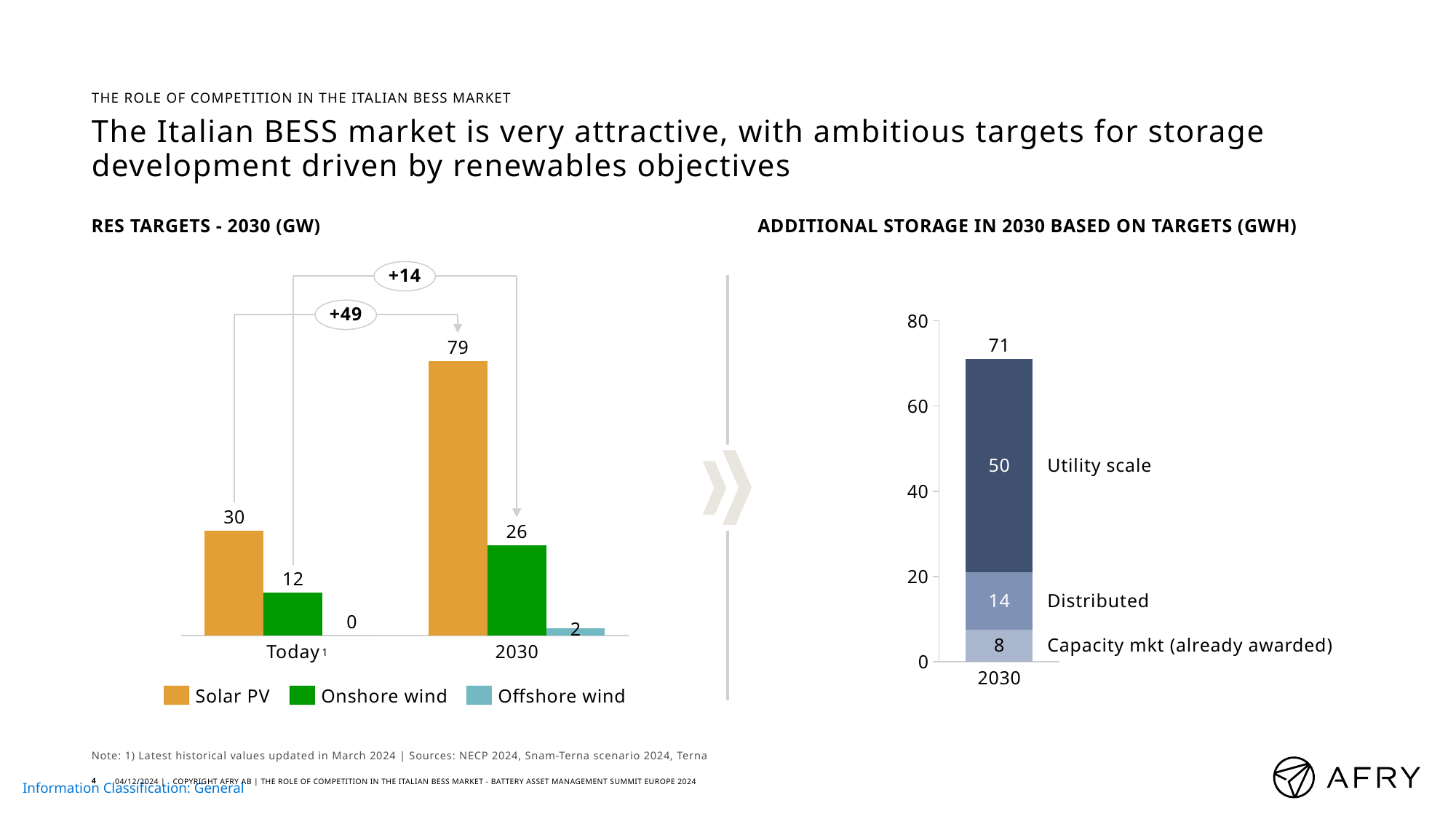
In the 'RES TARGETS - 2030 (GW)' chart, what is the value for Solar PV in 2030? 79 In the 'RES TARGETS - 2030 (GW)' chart, how many series does the legend list? 3 In the 'RES TARGETS - 2030 (GW)' chart, does Solar PV rise or fall from Today to 2030? rise In the 'RES TARGETS - 2030 (GW)' chart, what is the difference between Solar PV in 2030 and Solar PV Today? 49 In the 'ADDITIONAL STORAGE IN 2030 BASED ON TARGETS (GWH)' chart, which segment is larger, Distributed or Capacity mkt (already awarded)? Distributed In the 'RES TARGETS - 2030 (GW)' chart, what is the value for Onshore wind for Today? 12 In the 'RES TARGETS - 2030 (GW)' chart, which series has the highest value in 2030? Solar PV In the 'ADDITIONAL STORAGE IN 2030 BASED ON TARGETS (GWH)' chart, what is the value for Utility scale? 50 In the 'ADDITIONAL STORAGE IN 2030 BASED ON TARGETS (GWH)' chart, what is the total of the stacked bar for 2030? 71 In the 'RES TARGETS - 2030 (GW)' chart, what is the value for Offshore wind in 2030? 2 What kind of chart is the 'ADDITIONAL STORAGE IN 2030 BASED ON TARGETS (GWH)' chart? Stacked bar chart In the 'RES TARGETS - 2030 (GW)' chart, which series has the lowest value for Today? Offshore wind